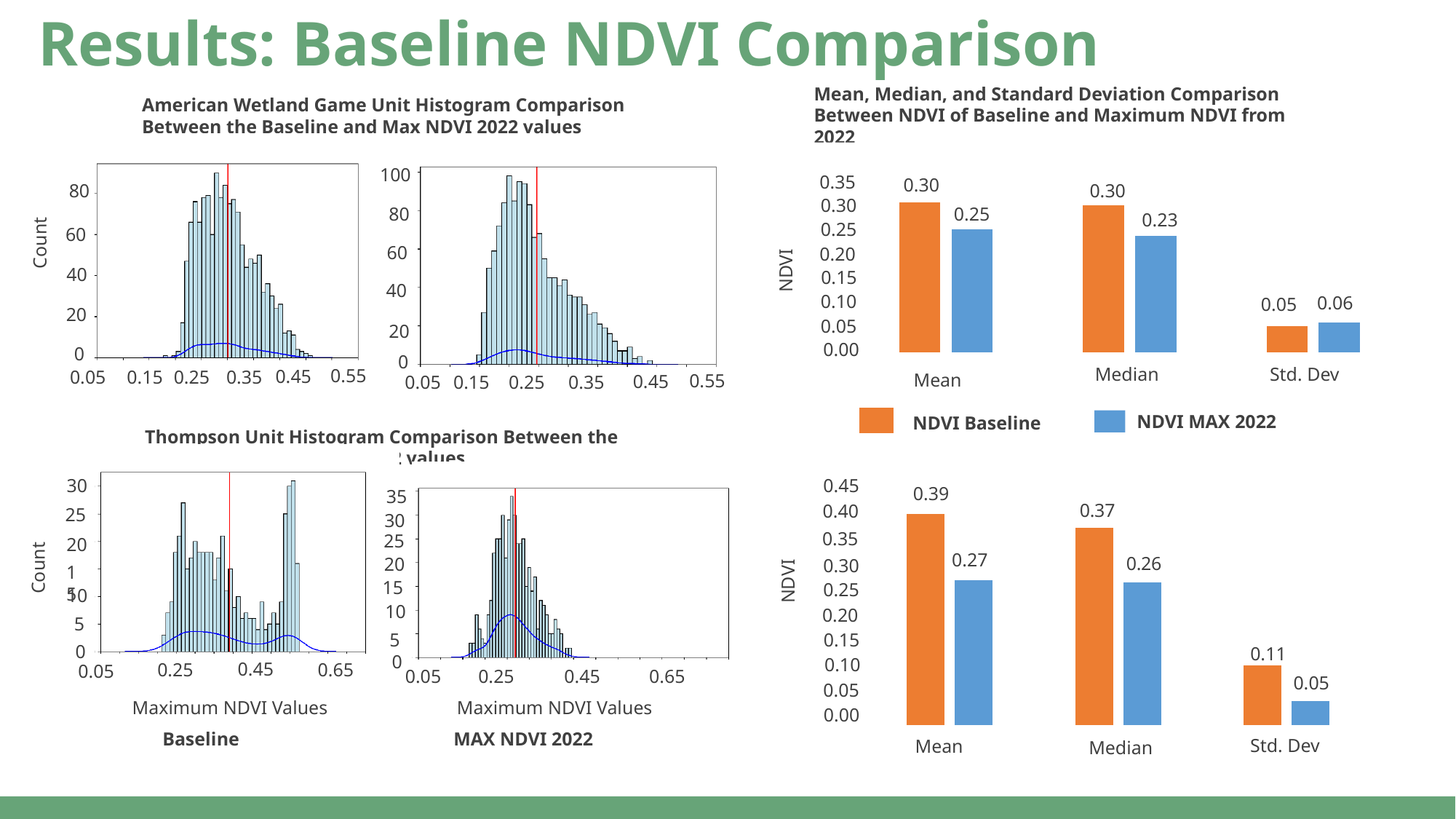
In the upper right bar chart, what is the NDVI Baseline value for Mean? 0.30 In the lower right bar chart, what is the NDVI MAX 2022 value for Std. Dev? 0.05 In the lower right bar chart, what is the difference between the NDVI Baseline and NDVI MAX 2022 values for Median? 0.11 How many series does the legend of the upper right bar chart list? 2 What kind of chart is the upper right chart comparing Mean, Median, and Std. Dev? Bar chart How many categories are shown on the x axis of the lower right bar chart? 3 In the lower right bar chart, which category has the lowest NDVI Baseline value? Std. Dev In the upper right bar chart, which series has the larger value for Std. Dev, NDVI Baseline or NDVI MAX 2022? NDVI MAX 2022 In the upper right bar chart, what is the NDVI MAX 2022 value for Median? 0.23 In the lower right bar chart, what is the NDVI Baseline value for Mean? 0.39 What is the y-axis label of the Thompson Unit Baseline histogram in the lower left? Count In the upper right bar chart, what is the difference between the NDVI Baseline and NDVI MAX 2022 values for Mean? 0.05